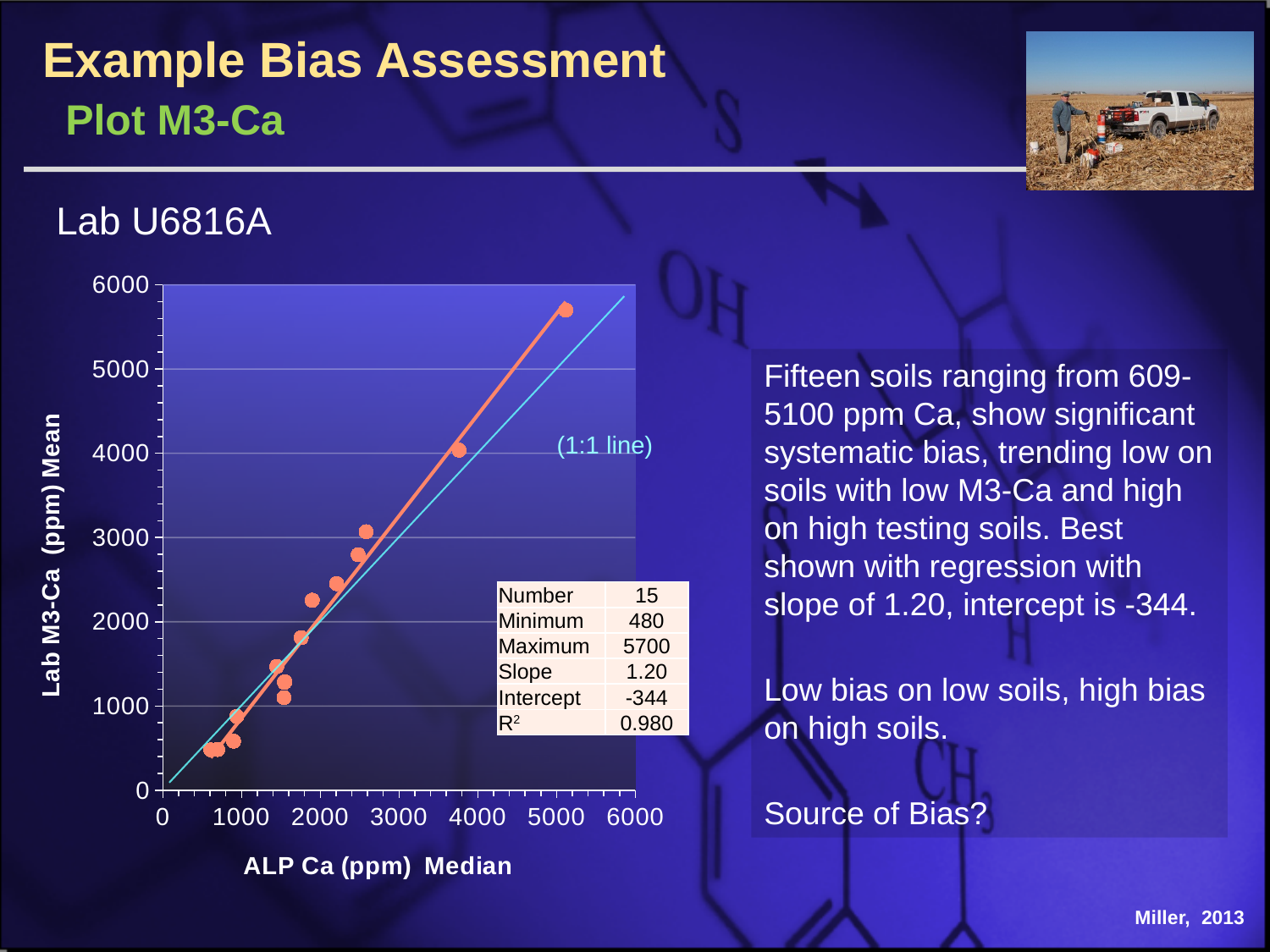
What is the Slope value shown in the table on the chart? 1.20 What is the Intercept value shown in the table on the chart? -344 According to the table on the chart, how many data points (Number) are plotted? 15 What is the title of the x axis of the chart? ALP Ca (ppm) Median What kind of chart is shown on the slide? scatter chart Do the Lab M3-Ca values rise or fall as ALP Ca Median increases along the x axis? rise What is the title of the y axis of the chart? Lab M3-Ca (ppm) Mean What is the Minimum value shown in the table on the chart? 480 What is the Maximum value shown in the table on the chart? 5700 Is the Lab M3-Ca value of the lowest plotted point (near 600 ppm ALP Ca) greater or less than 1000? less What is the R² value shown in the table on the chart? 0.980 Is the Lab M3-Ca value of the highest plotted point (near 5100 ppm ALP Ca) greater or less than 5000? greater